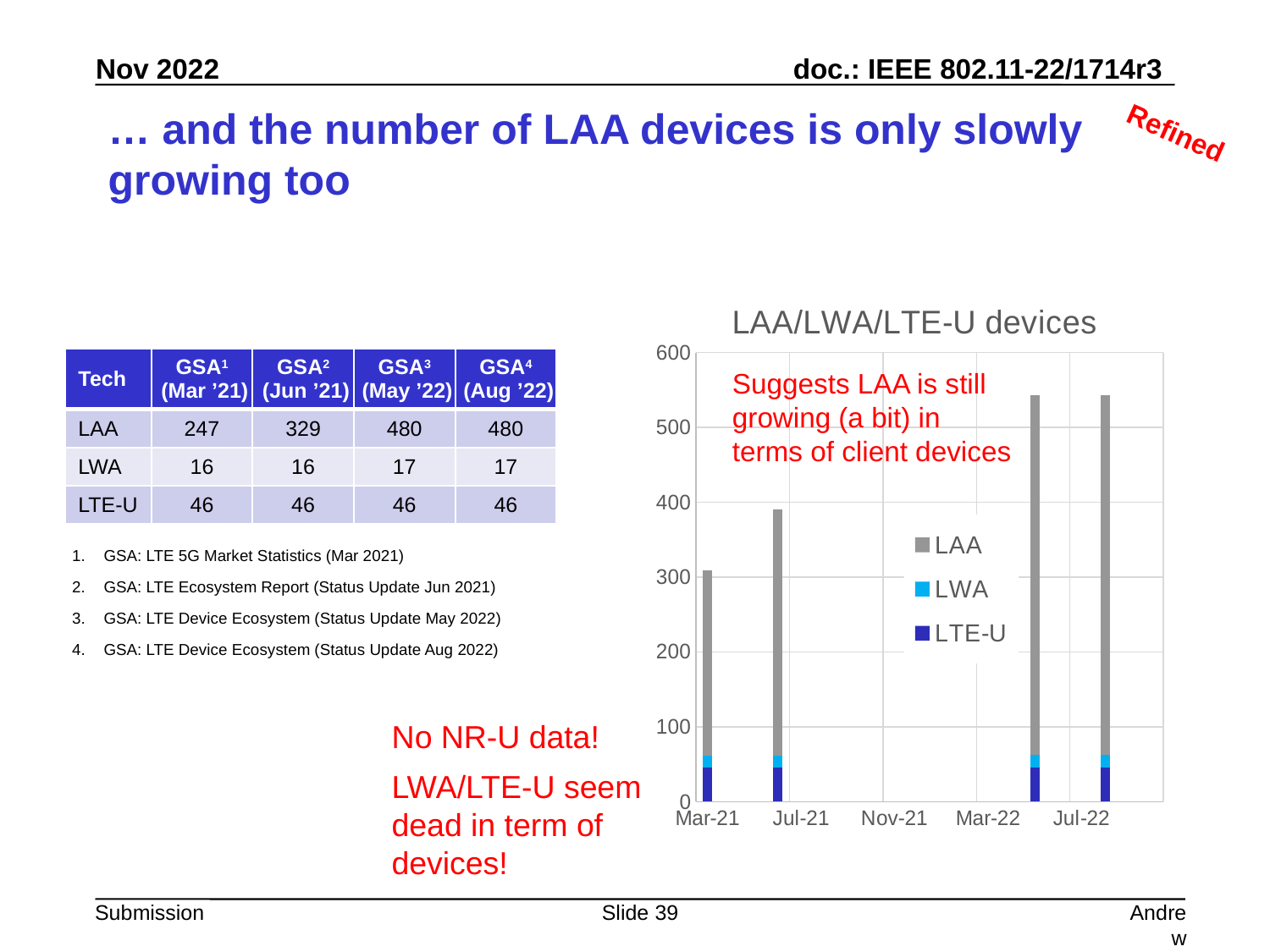
Is the LTE-U segment of the first bar greater or less than 100? less How many bars are plotted in the chart? 4 How many series does the chart's legend list? 3 Which is taller, the first bar (Mar-21) or the third bar (after Mar-22)? the third bar Is the total height of the last bar (near Jul-22) greater or less than 500? greater Is the total height of the second bar (near Jul-21) greater or less than 300? greater Which bar has the lowest total height? Mar-21 Do the bar totals rise or fall from left to right along the x axis? rise Which series is shown in grey in the chart? LAA What kind of chart is shown on the slide? stacked bar chart What is the title of the chart? LAA/LWA/LTE-U devices